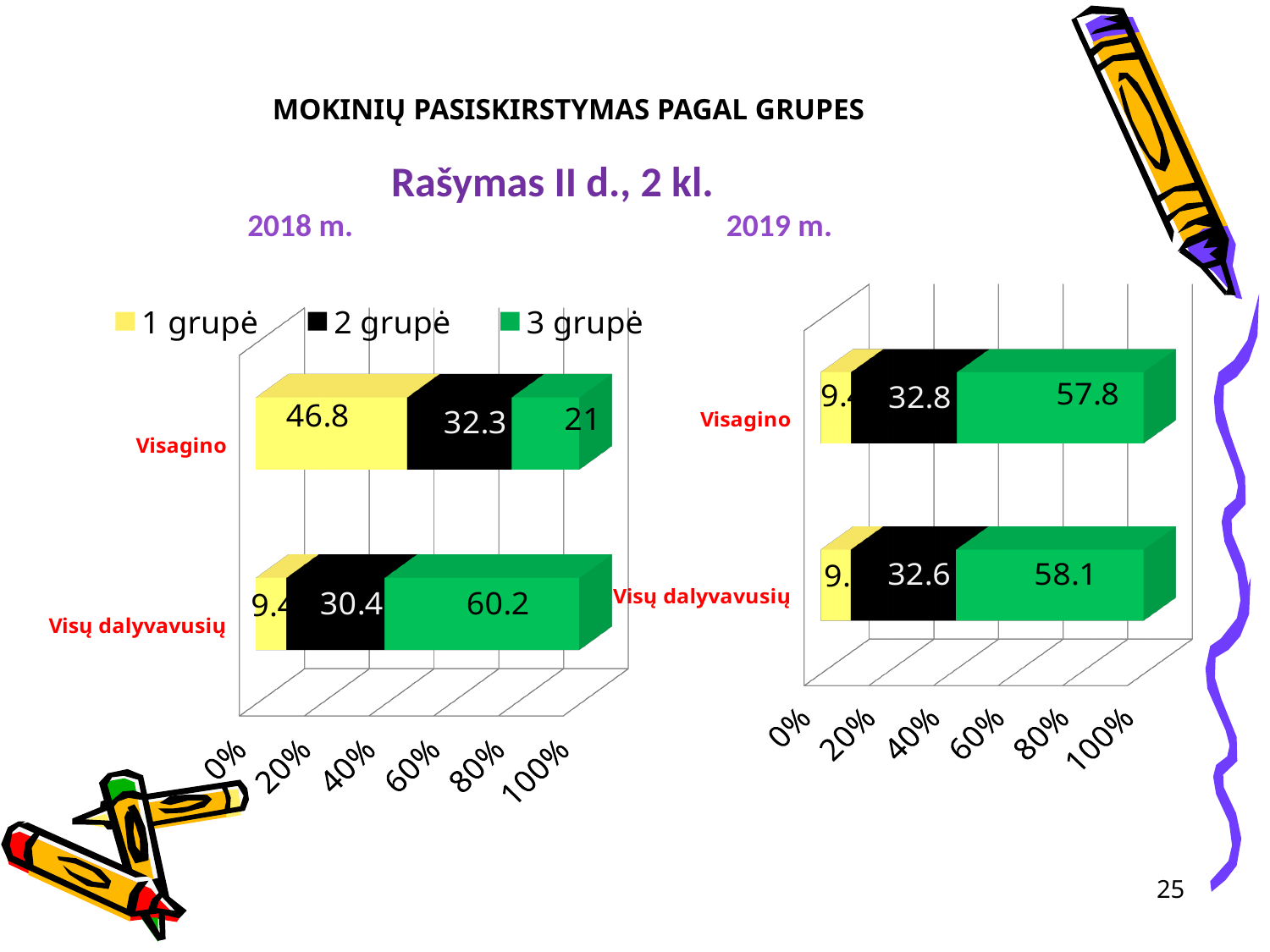
In the 2019 m. chart, what is the value of 2 grupė for Visagino? 32.8 In the 2018 m. chart, which category has the larger 3 grupė value, Visagino or Visų dalyvavusių? Visų dalyvavusių In the 2019 m. chart, what is the difference between the 3 grupė values for Visų dalyvavusių and Visagino? 0.3 What kind of chart is the 2019 m. chart? Stacked bar chart How many categories are shown in the 2019 m. chart? 2 In the 2019 m. chart, what is the value of 3 grupė for Visų dalyvavusių? 58.1 In the 2018 m. chart, which group has the largest segment for Visagino? 1 grupė In the 2018 m. chart, what is the value of 1 grupė for Visagino? 46.8 In the 2018 m. chart, what is the value of 3 grupė for Visų dalyvavusių? 60.2 In the 2018 m. chart, what is the total of the Visų dalyvavusių stacked bar? 100 In the 2018 m. chart, what is the difference between the 1 grupė and 2 grupė values for Visagino? 14.5 How many series does the legend of the 2018 m. chart list? 3